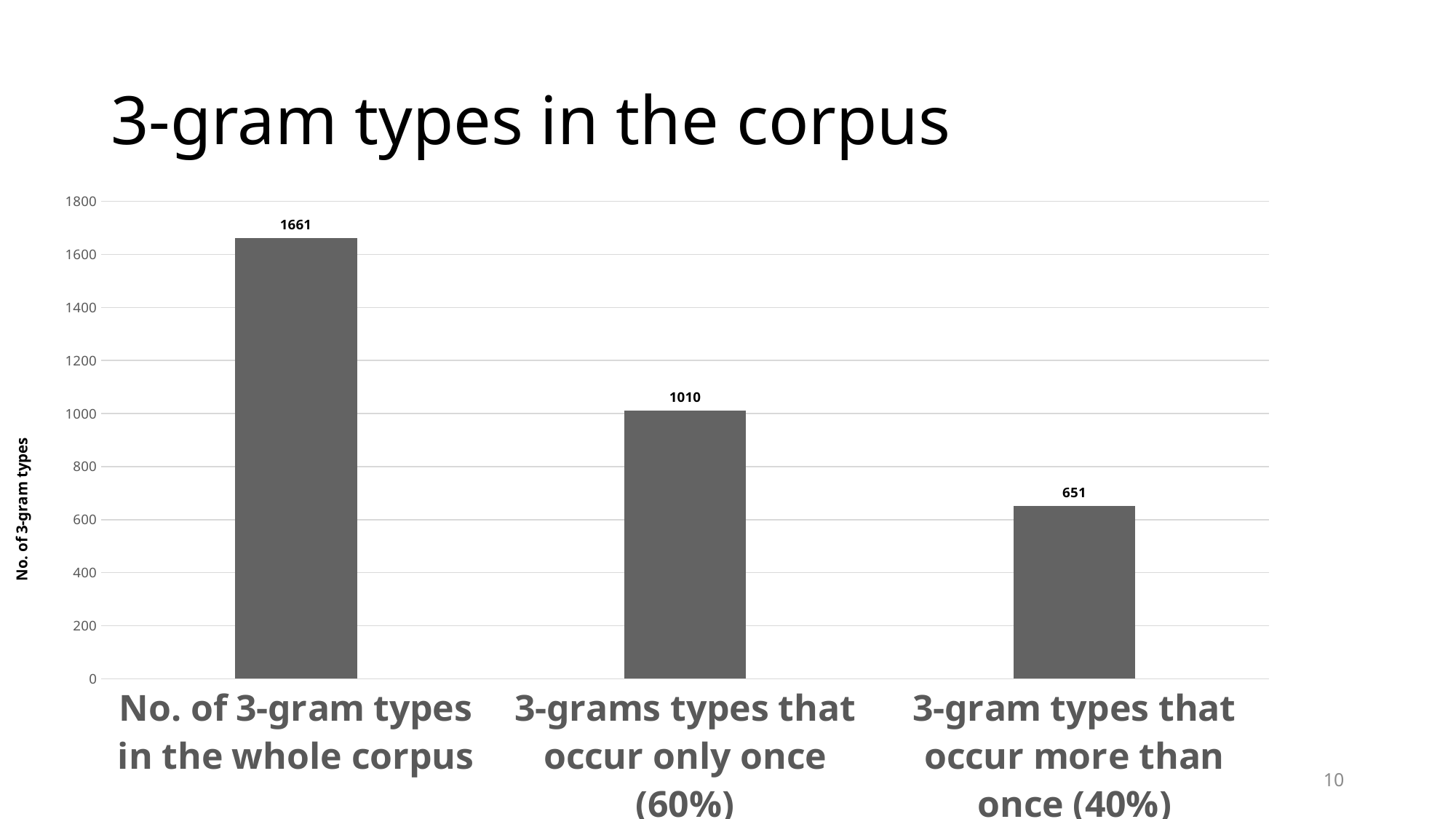
Which category has the highest value? No. of 3-gram types in the whole corpus How many 3-gram types occur only once? 1010 How many 3-gram types occur more than once? 651 How many categories are shown in the chart? 3 What is the number of 3-gram types in the whole corpus? 1661 Is the value for 3-gram types that occur more than once greater or less than 800? less What is the difference between the number of 3-gram types that occur only once and those that occur more than once? 359 Do the values rise or fall from left to right across the categories? fall What kind of chart is shown on the slide? bar chart Which category has the lowest value? 3-gram types that occur more than once (40%) Which is larger: the number of 3-gram types that occur only once or the number that occur more than once? 3-grams types that occur only once (60%) What is the label of the vertical axis? No. of 3-gram types